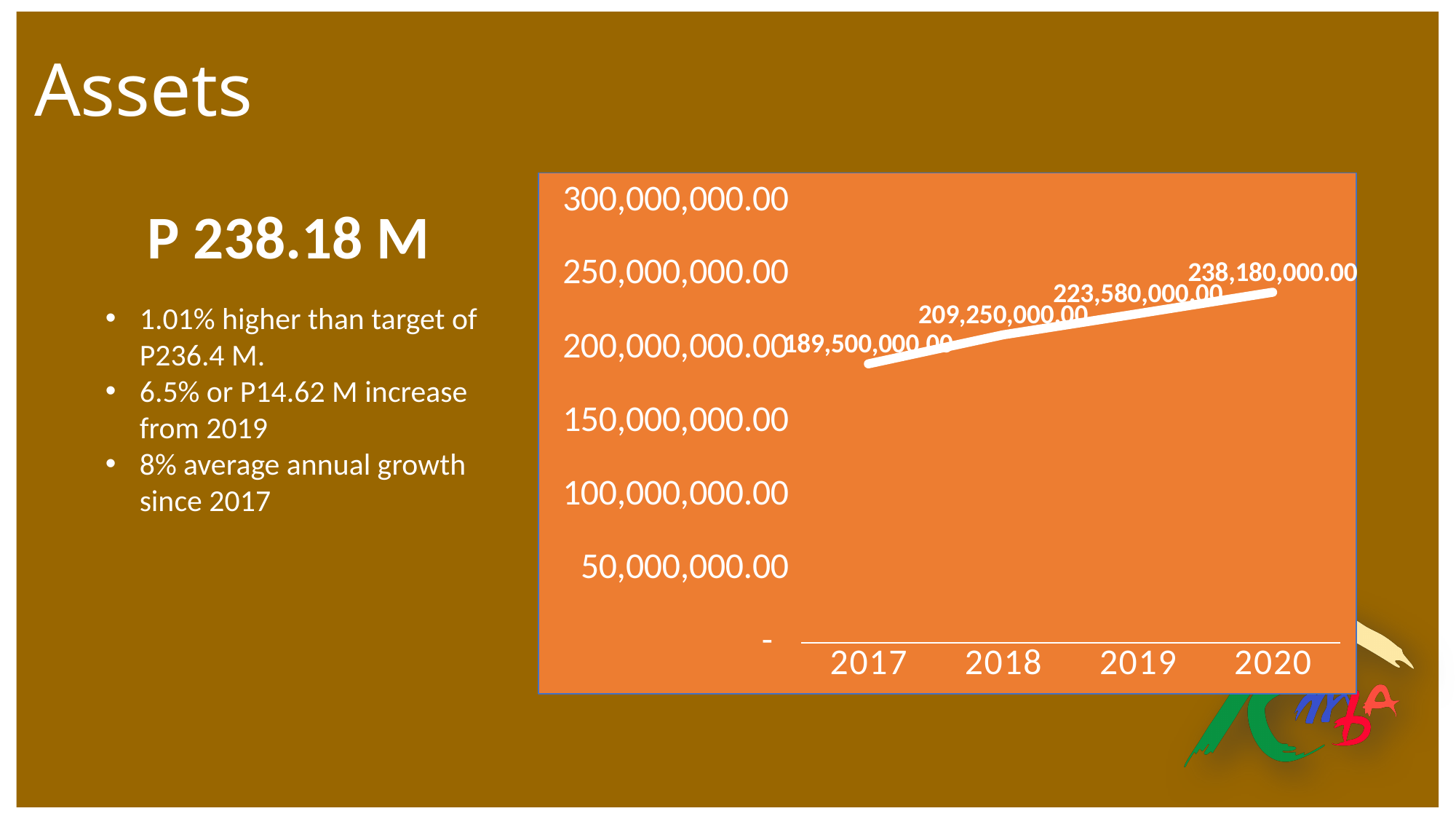
What kind of chart is shown on the slide? line chart What is the value plotted for 2020? 238,180,000.00 What is the difference between the 2020 value and the 2019 value? 14,600,000.00 How many years are plotted on the x axis of the chart? 4 What is the value plotted for 2017? 189,500,000.00 What is the difference between the 2018 value and the 2017 value? 19,750,000.00 Which is larger, the value for 2018 or the value for 2019? 2019 Which year has the highest value on the chart? 2020 What is the value plotted for 2019? 223,580,000.00 Do the values rise or fall from 2017 to 2020? rise What is the value plotted for 2018? 209,250,000.00 Which year has the lowest value on the chart? 2017